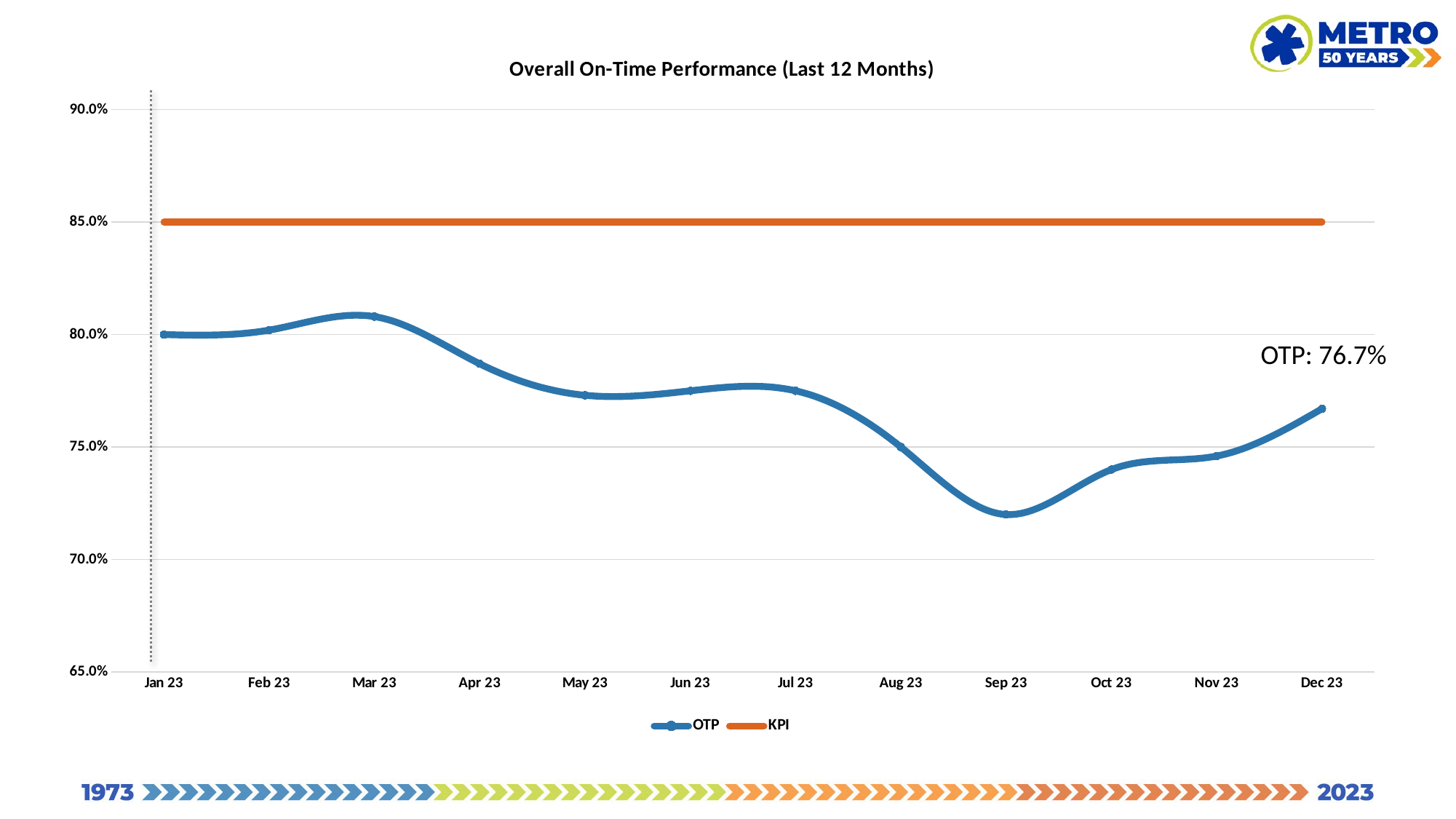
What value does the KPI line sit at? 85.0% Is the OTP value for Sep 23 greater or less than 75.0%? less In which month is OTP highest? Mar 23 How many months are plotted along the x axis? 12 How many series does the legend list? 2 In which month is OTP lowest? Sep 23 What is the title of the chart? Overall On-Time Performance (Last 12 Months) What is the OTP value for Dec 23? 76.7% Which is larger, the OTP value for Jan 23 or for Aug 23? Jan 23 Does OTP rise or fall from Jul 23 to Sep 23? fall What kind of chart is shown on the slide? line chart Is the OTP value for Mar 23 greater or less than 80.0%? greater